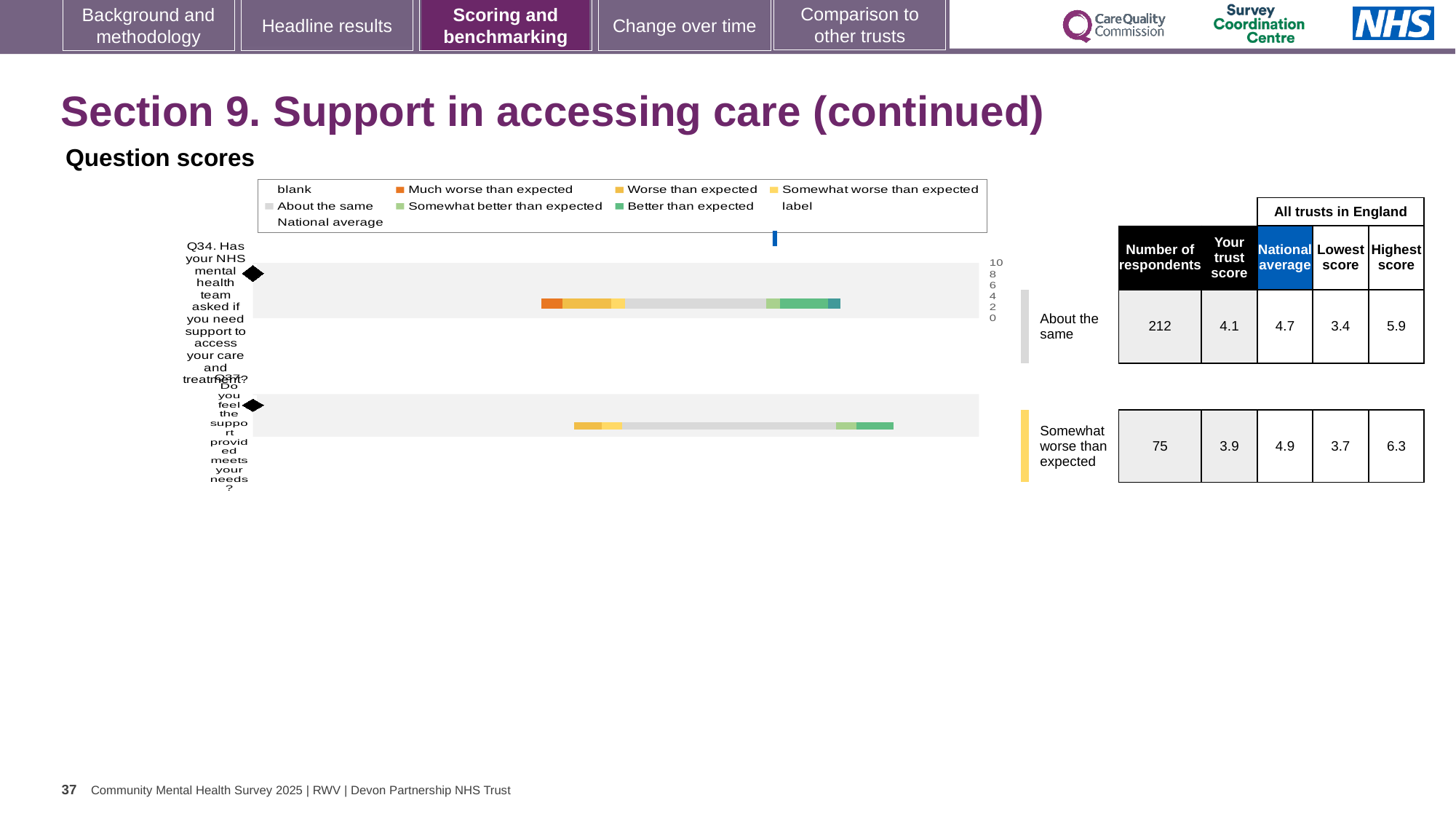
By how much does the national average exceed the trust score for Q34? 0.6 What is the highest score among all trusts in England for Q37? 6.3 What is the lowest score among all trusts in England for Q34? 3.4 Which question has the larger number of respondents, Q34 or Q37? Q34 What benchmark category is shown for Q37? Somewhat worse than expected What is the trust score for Q34 (Has your NHS mental health team asked if you need support to access your care and treatment?)? 4.1 How many respondents answered Q37 (Do you feel the support provided meets your needs?)? 75 For Q34, which is larger: the trust score or the national average? National average What kind of chart is used to show the question scores? Bar chart How many questions are plotted in the Question scores chart? 2 What is the difference between the highest score and the lowest score for Q37? 2.6 What is the national average score for Q34? 4.7